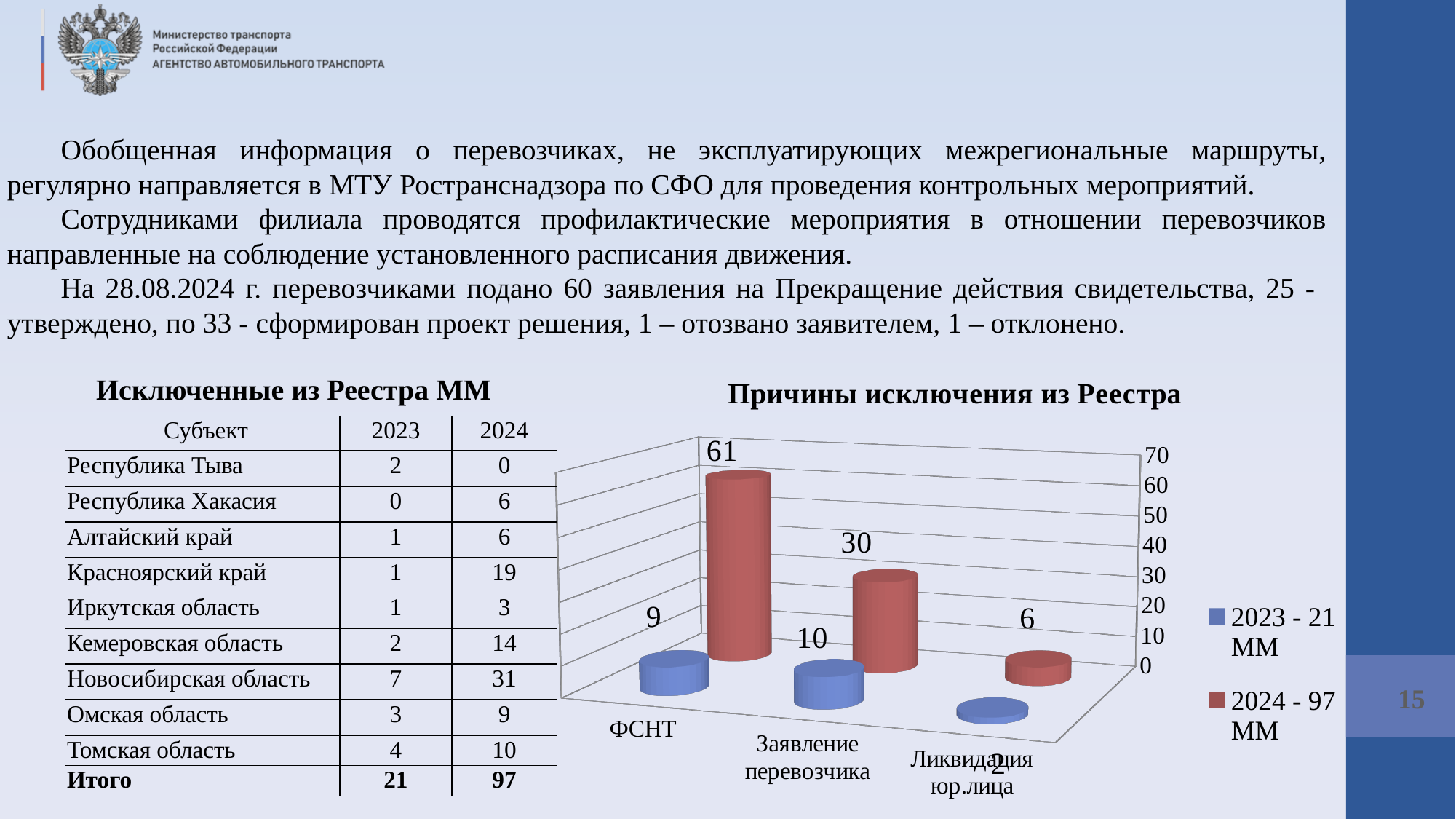
In the chart "Причины исключения из Реестра", which category has the lowest 2023 value? Ликвидация юр.лица In the chart "Причины исключения из Реестра", which is larger: the 2024 value for Заявление перевозчика or the 2024 value for Ликвидация юр.лица? Заявление перевозчика In the chart "Причины исключения из Реестра", what is the 2023 value for Заявление перевозчика? 10 In the chart "Причины исключения из Реестра", what is the difference between the 2024 and 2023 values for ФСНТ? 52 How many series does the legend of the chart "Причины исключения из Реестра" list? 2 In the chart "Причины исключения из Реестра", what is the 2023 value for ФСНТ? 9 What type of chart is "Причины исключения из Реестра"? bar chart In the chart "Причины исключения из Реестра", which category has the highest 2024 value? ФСНТ In the chart "Причины исключения из Реестра", what is the 2024 value for ФСНТ? 61 In the chart "Причины исключения из Реестра", what is the 2024 value for Ликвидация юр.лица? 6 How many categories are shown on the x axis of the chart "Причины исключения из Реестра"? 3 In the chart "Причины исключения из Реестра", which colour represents the series "2024 - 97 ММ"? red